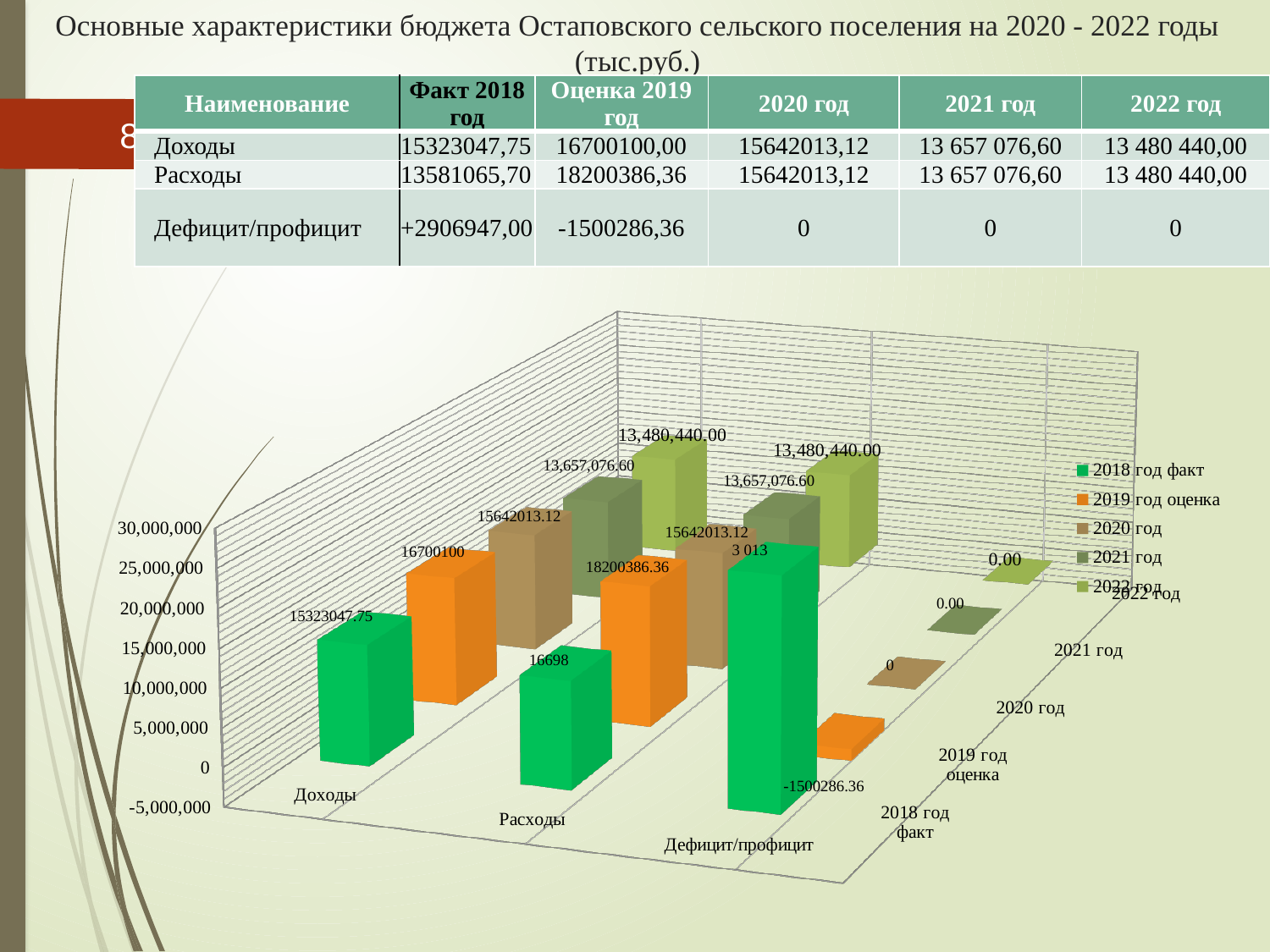
How many series does the legend list? 5 What kind of chart is shown on the slide? bar chart What is the value of Доходы for the 2022 год series? 13,480,440.00 What is the value of Доходы for the 2018 год факт series? 15323047.75 Is the value of Доходы for 2018 год факт greater or less than 20,000,000? less What is the value of Дефицит/профицит for the 2019 год оценка series? -1500286.36 Which series has the highest value for Доходы? 2019 год оценка What is the value of Доходы for the 2019 год оценка series? 16700100 What is the value of Расходы for the 2019 год оценка series? 18200386.36 For the 2019 год оценка series, which is larger: Доходы or Расходы? Расходы How many categories are shown along the category axis of the chart? 3 For the 2019 год оценка series, what is the difference between Расходы and Доходы? 1500286.36